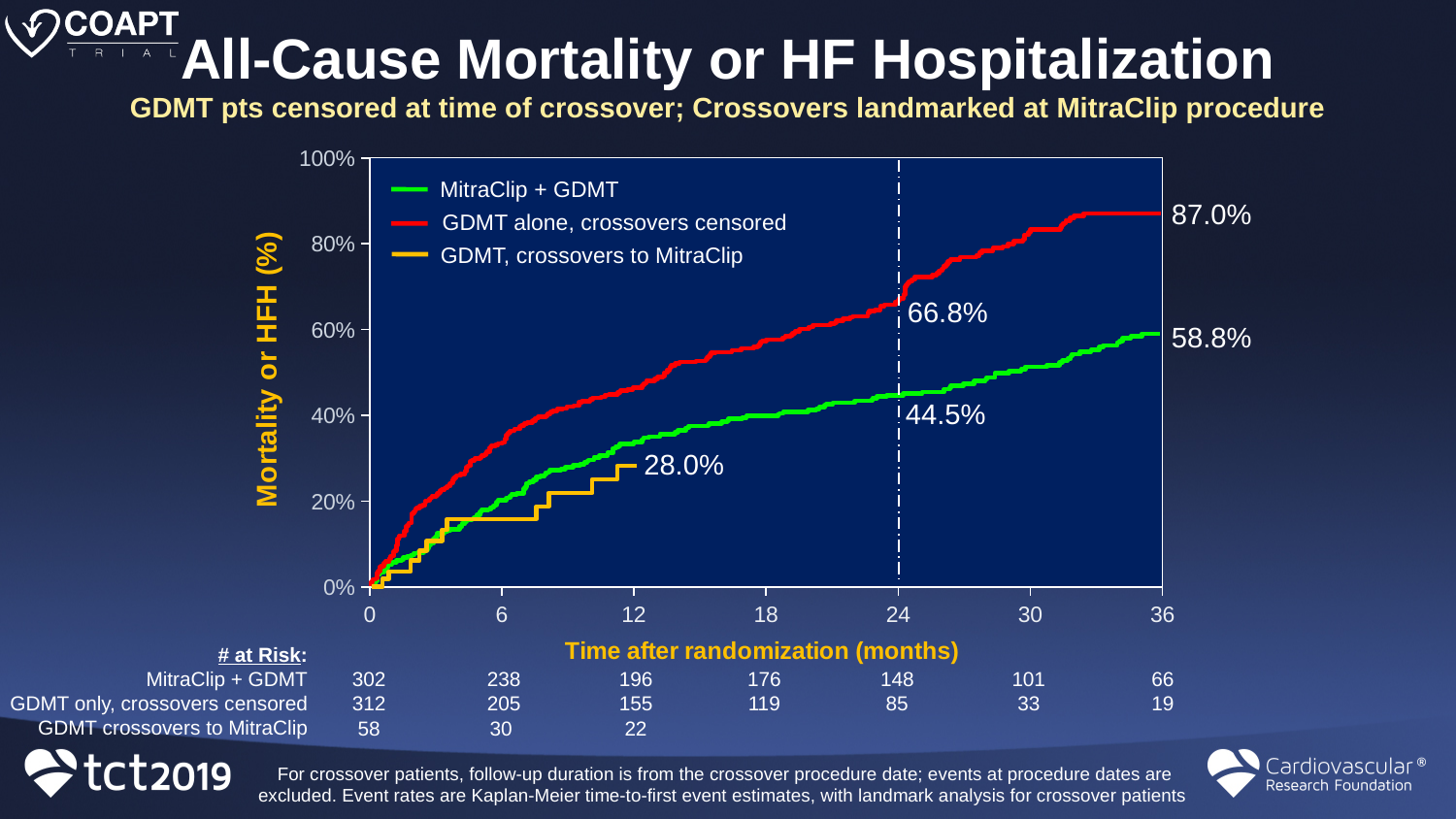
What is the event rate for the GDMT alone, crossovers censored group at 36 months? 87.0% What is the event rate for the MitraClip + GDMT group at 24 months? 44.5% How many series does the legend list? 3 What is the event rate for the GDMT alone, crossovers censored group at 24 months? 66.8% What is the difference between the 24-month event rates of the GDMT alone, crossovers censored group and the MitraClip + GDMT group? 22.3% What is the event rate for the MitraClip + GDMT group at 36 months? 58.8% Do the event rates rise or fall as time after randomization increases? rise What is the final labelled event rate for the GDMT, crossovers to MitraClip curve? 28.0% Which group has the higher event rate at 24 months: MitraClip + GDMT or GDMT alone, crossovers censored? GDMT alone, crossovers censored What is the label of the y axis? Mortality or HFH (%) How many MitraClip + GDMT patients were at risk at 24 months? 148 What is the difference between the 36-month event rates of the GDMT alone, crossovers censored group and the MitraClip + GDMT group? 28.2%